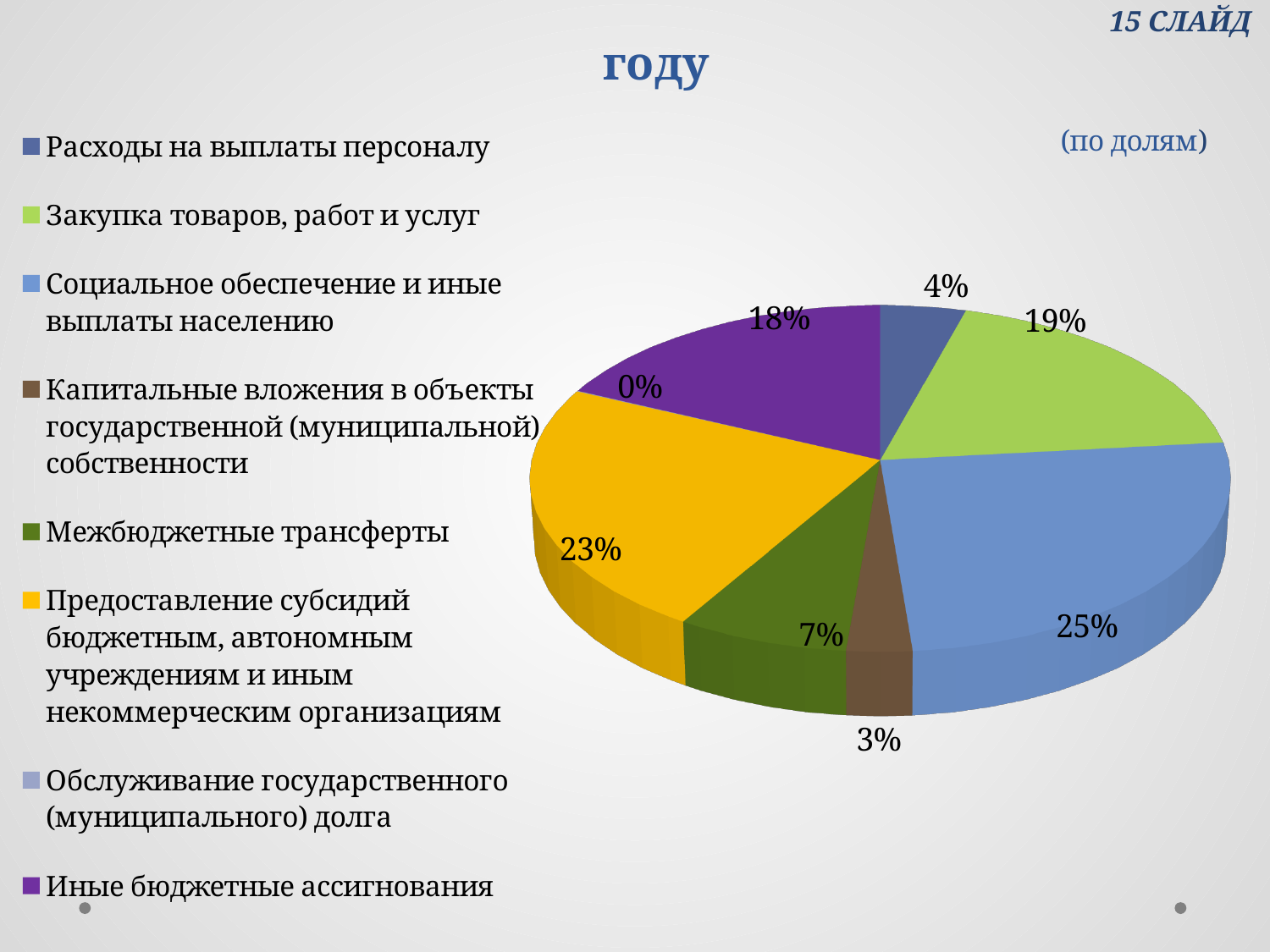
Which category has the smallest share in the pie chart? Обслуживание государственного (муниципального) долга What share does "Социальное обеспечение и иные выплаты населению" have in the pie chart? 25% What kind of chart is shown on the slide? pie chart What is the difference in percentage points between "Межбюджетные трансферты" and "Капитальные вложения в объекты государственной (муниципальной) собственности"? 4 percentage points What share does "Расходы на выплаты персоналу" have in the pie chart? 4% How many categories does the legend of the pie chart list? 8 What share does "Предоставление субсидий бюджетным, автономным учреждениям и иным некоммерческим организациям" have? 23% Which is larger: the share of "Закупка товаров, работ и услуг" or the share of "Иные бюджетные ассигнования"? Закупка товаров, работ и услуг What share does "Закупка товаров, работ и услуг" have in the pie chart? 19% What share does "Иные бюджетные ассигнования" have in the pie chart? 18% Which category has the largest share in the pie chart? Социальное обеспечение и иные выплаты населению What share does "Обслуживание государственного (муниципального) долга" have in the pie chart? 0%